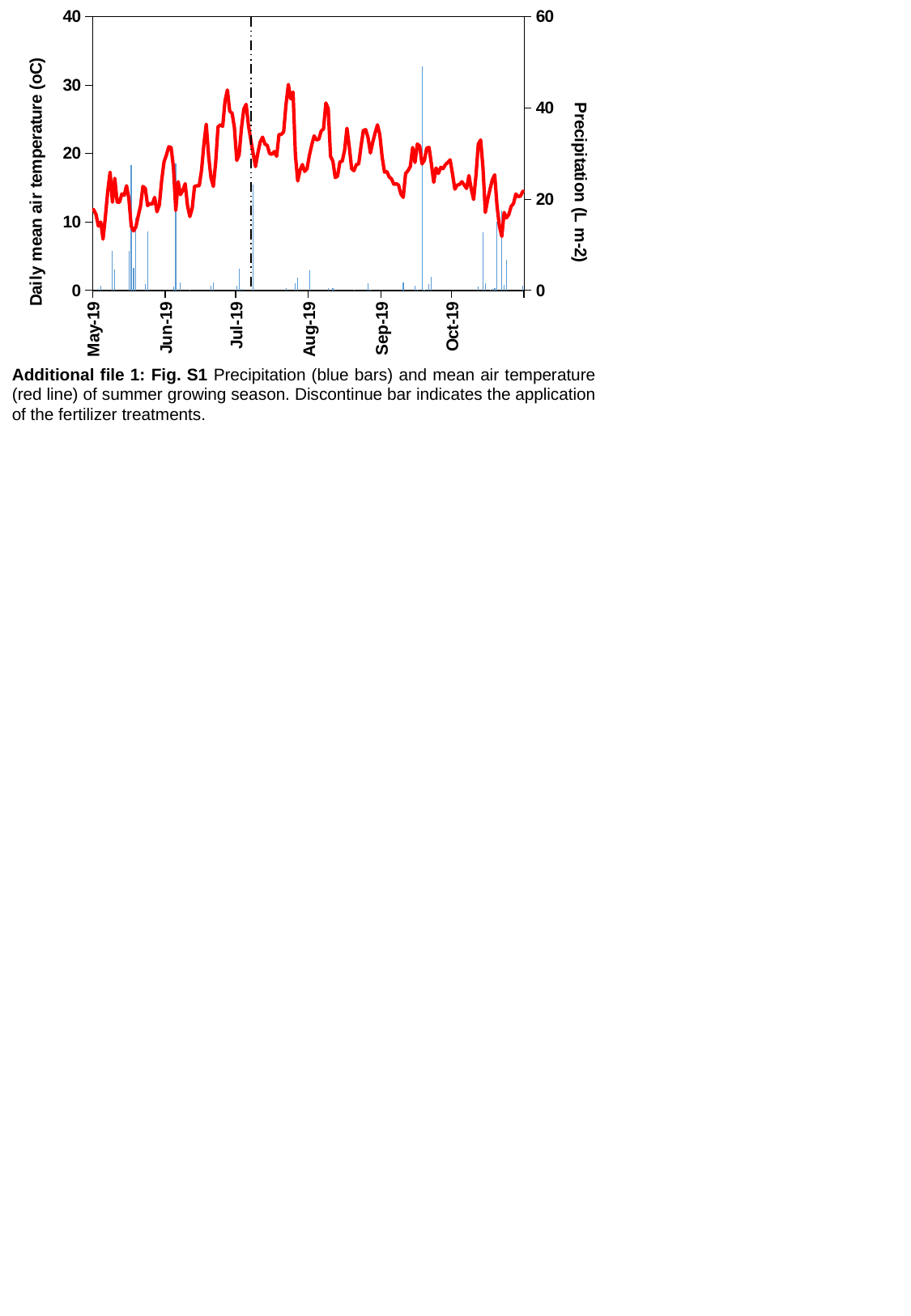
Does the daily mean air temperature generally rise or fall from Aug-19 to Oct-19? fall What is the label of the right y-axis? Precipitation (L m-2) Is the daily mean air temperature at the Jul-19 tick greater or less than 10? greater Is the daily mean air temperature at the start of May-19 greater or less than 20? less How many month labels are shown on the x-axis? 6 What is the maximum value shown on the right y-axis (precipitation)? 60 Is the tallest precipitation bar greater or less than 40 L m-2? greater What is the label of the left y-axis? Daily mean air temperature (oC) Does the daily mean air temperature generally rise or fall from May-19 to Jul-19? rise What kind of chart is shown on the slide? A combined line and bar chart